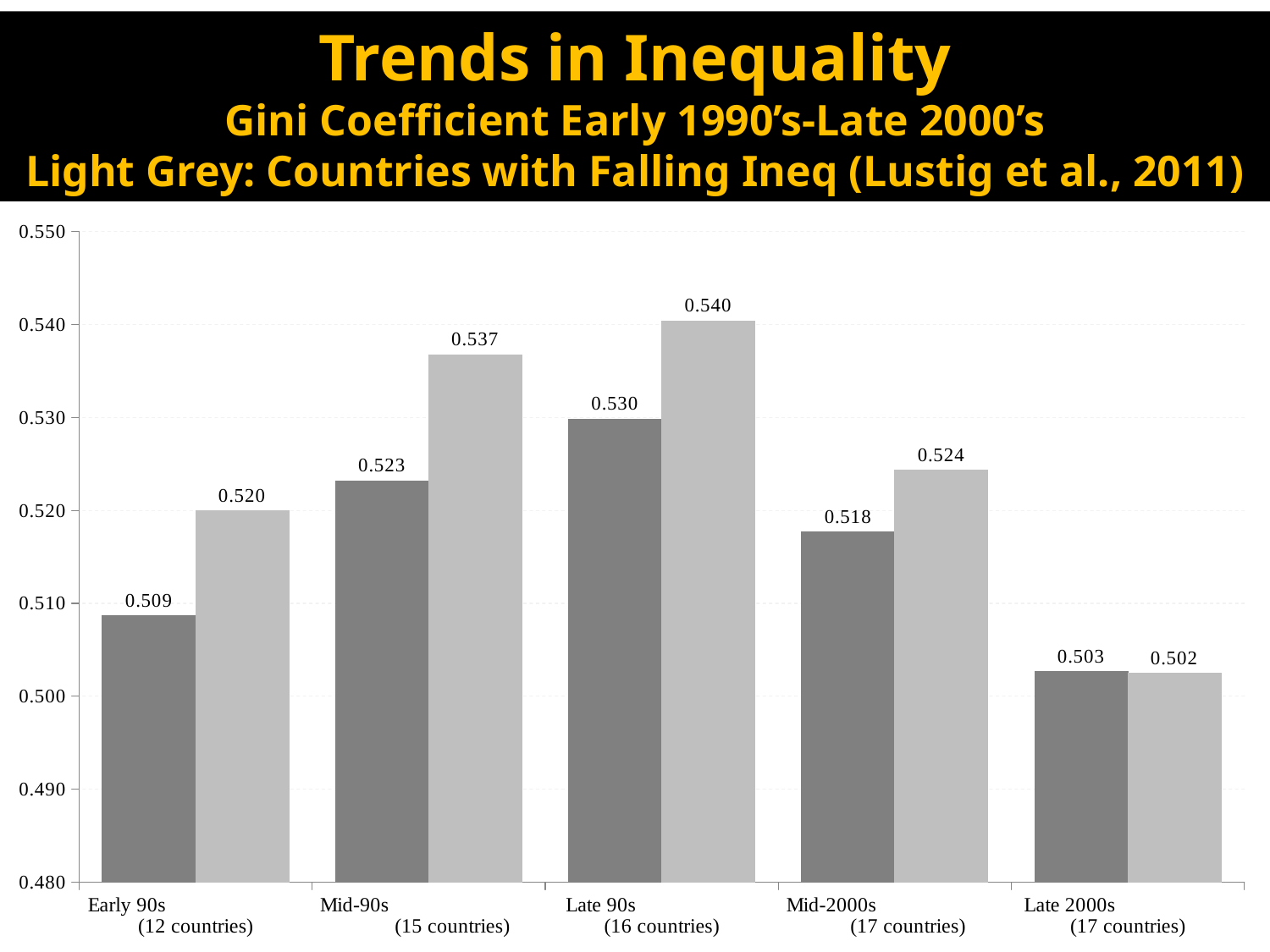
Is the light grey bar value for Mid-2000s greater or less than 0.520? greater Which period has the highest light grey bar? Late 90s Which is larger for Early 90s, the dark grey bar or the light grey bar? light grey bar What is the light grey bar value for Late 90s? 0.540 According to the slide title, what do the light grey bars represent? Countries with Falling Ineq How many period categories are shown on the x axis? 5 Which period has the lowest dark grey bar? Late 2000s What is the dark grey bar value for Mid-2000s? 0.518 What is the difference between the light grey and dark grey bars for Mid-90s? 0.014 What is the dark grey bar value for Early 90s? 0.509 What type of chart is shown on the slide? bar chart How many countries are included in the Late 90s category? 16 countries